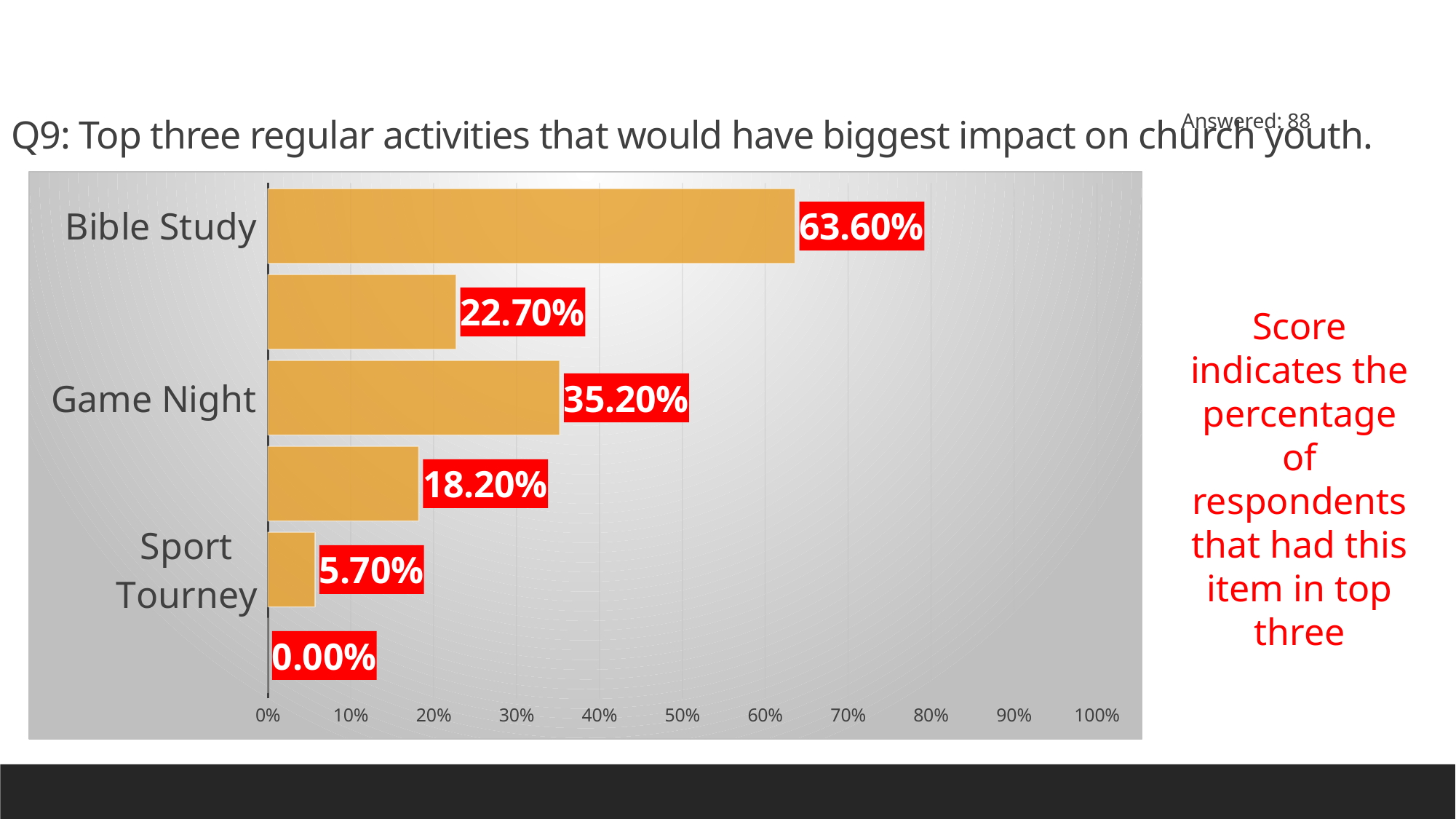
Which is larger, the value for Game Night or the value for Sport Tourney? Game Night What kind of chart is shown on the slide? bar chart What is the value for Game Night? 35.20% What is the lowest value printed on any bar in the chart? 0.00% What is the value for Bible Study? 63.60% How many respondents answered the question, according to the slide? 88 How many bars are plotted in the chart? 6 What is the difference between the values for Game Night and Sport Tourney? 29.50% Which labelled category has the highest value? Bible Study What is the difference between the values for Bible Study and Game Night? 28.40% What is the value for Sport Tourney? 5.70% Is the value for Bible Study greater or less than 50%? greater